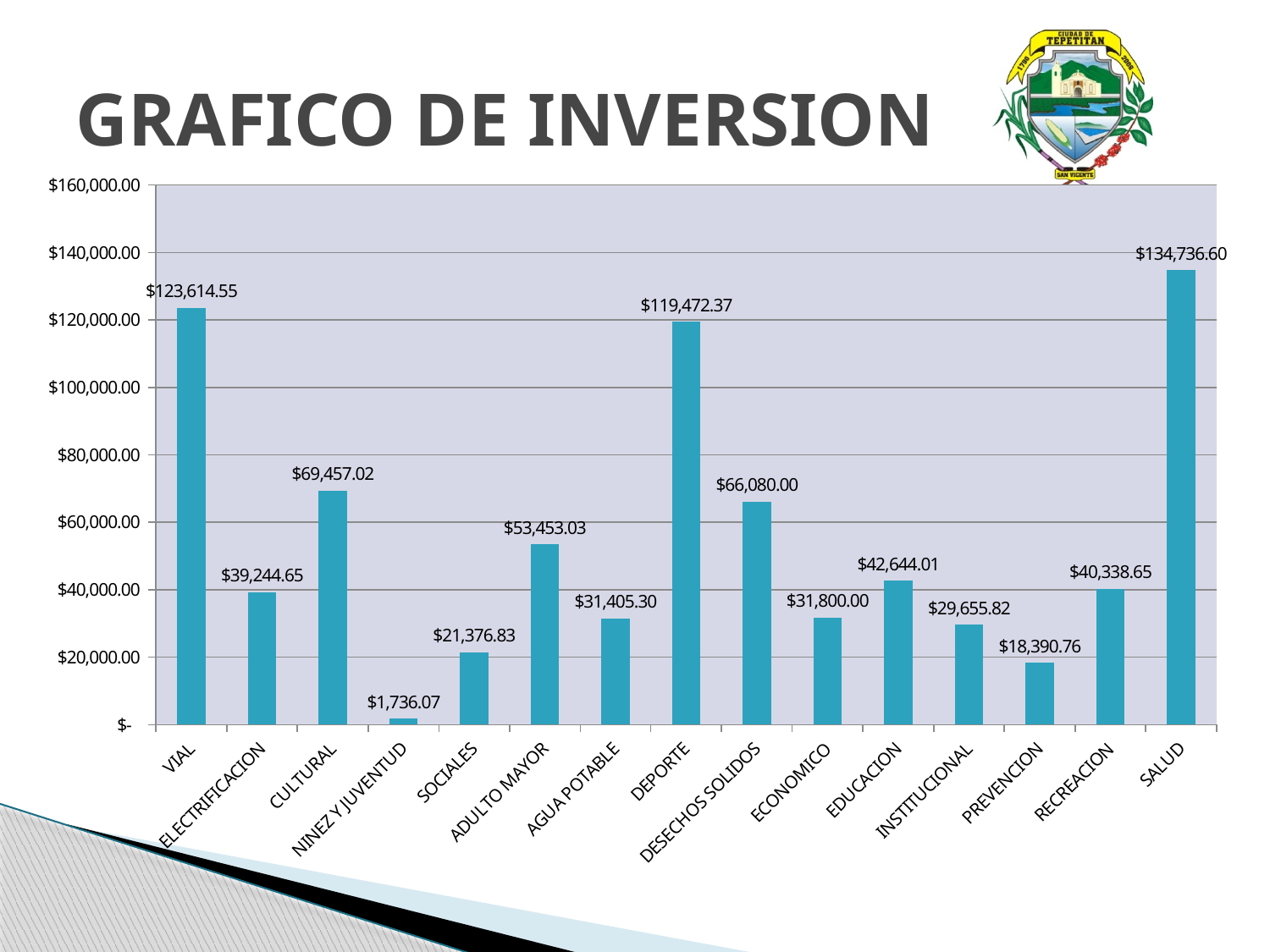
What is the value for SALUD? $134,736.60 Which is larger, the value for CULTURAL or the value for DESECHOS SOLIDOS? CULTURAL What is the title of the slide? GRAFICO DE INVERSION What is the value for ADULTO MAYOR? $53,453.03 Which category has the highest value? SALUD How many categories are shown on the x axis? 15 Is the value for DEPORTE greater or less than $100,000.00? greater What is the difference between the values for SALUD and VIAL? $11,122.05 Which category has the lowest value? NINEZ Y JUVENTUD What kind of chart is shown on the slide? bar chart What is the difference between the values for DESECHOS SOLIDOS and ECONOMICO? $34,280.00 What is the value for DEPORTE? $119,472.37